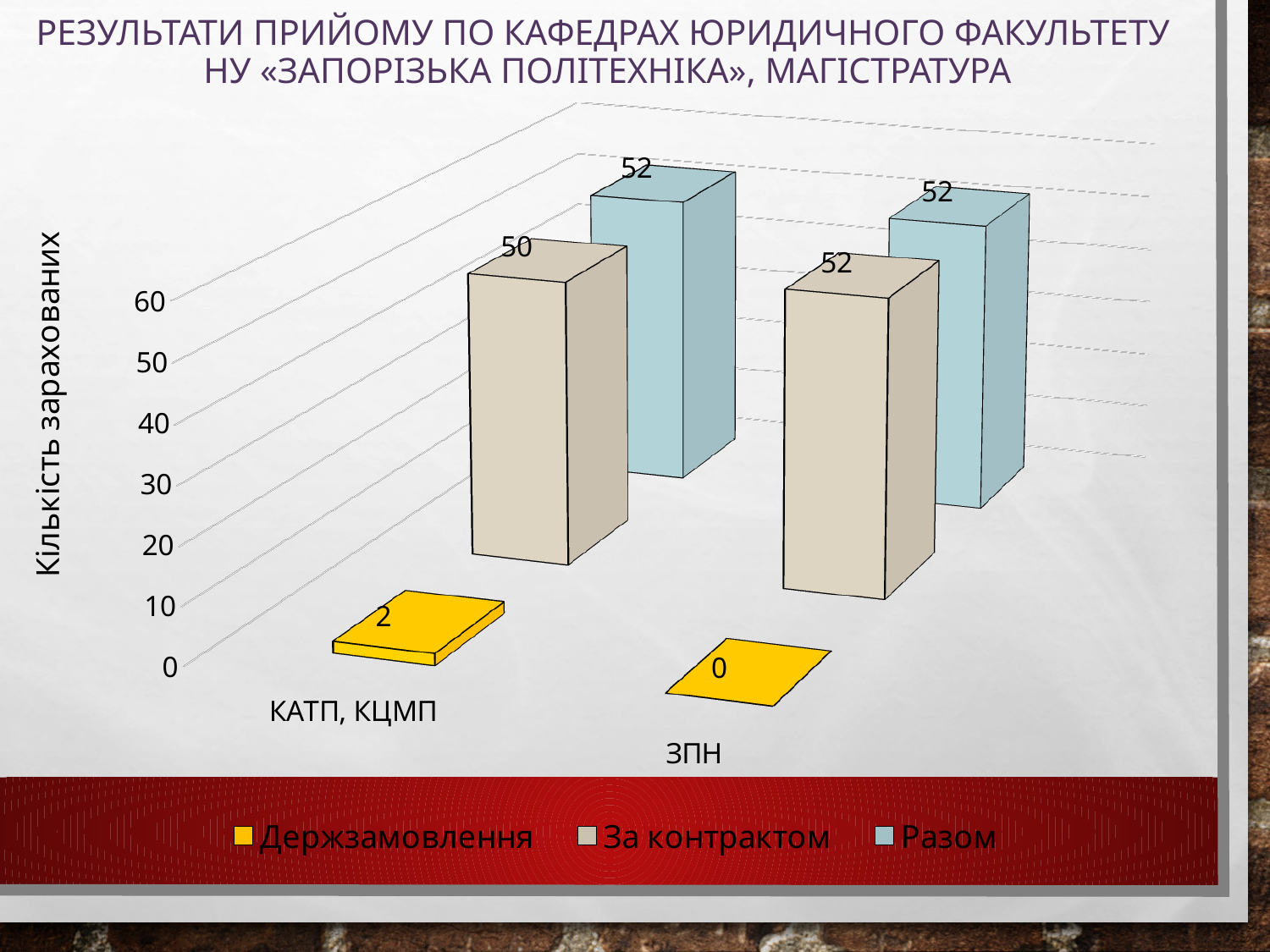
What is the label of the vertical axis? Кількість зарахованих What is the value of За контрактом for ЗПН? 52 How many series does the legend list? 3 What is the value of Держзамовлення for КАТП, КЦМП? 2 What is the difference between the За контрактом values for ЗПН and КАТП, КЦМП? 2 What is the value of Держзамовлення for ЗПН? 0 Which is larger: За контрактом for КАТП, КЦМП or За контрактом for ЗПН? За контрактом for ЗПН What is the value of Разом for ЗПН? 52 What is the value of За контрактом for КАТП, КЦМП? 50 How many categories are shown on the x axis? 2 Which category has the lower value for Держзамовлення? ЗПН What kind of chart is shown on the slide? Bar chart